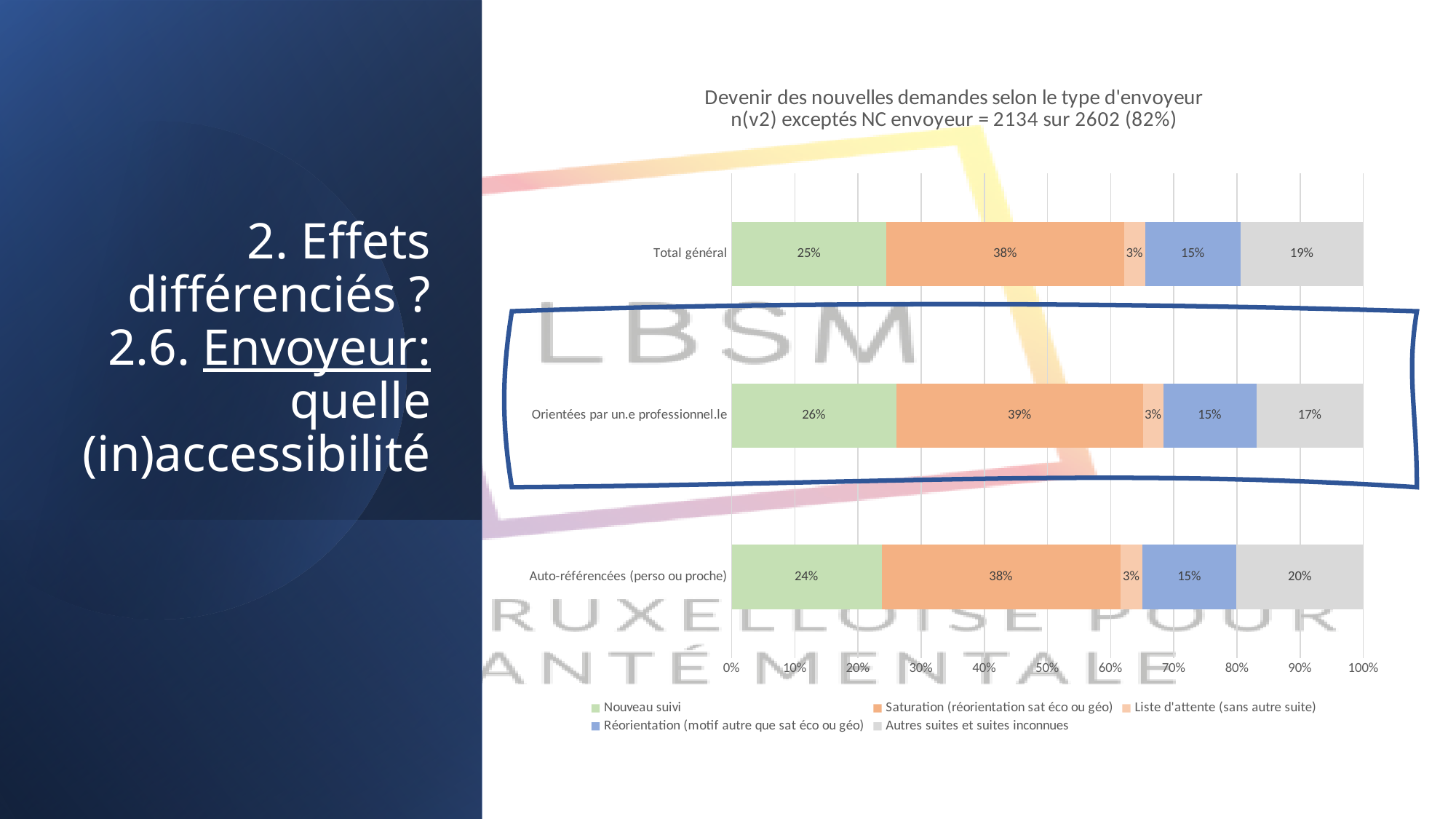
What is the value of "Réorientation (motif autre que sat éco ou géo)" for "Auto-référencées (perso ou proche)"? 15% Which category has the highest value for "Nouveau suivi"? Orientées par un.e professionnel.le What kind of chart is shown on the slide? Stacked bar chart What colour represents "Liste d'attente (sans autre suite)" in the chart? Light orange What is the value of "Autres suites et suites inconnues" for "Auto-référencées (perso ou proche)"? 20% What is the value of "Saturation (réorientation sat éco ou géo)" for "Total général"? 38% What is the difference between the "Autres suites et suites inconnues" values for "Auto-référencées (perso ou proche)" and "Orientées par un.e professionnel.le"? 3% Which is larger: the "Saturation (réorientation sat éco ou géo)" value for "Orientées par un.e professionnel.le" or for "Auto-référencées (perso ou proche)"? Orientées par un.e professionnel.le How many categories are shown on the chart? 3 What is the value of "Nouveau suivi" for "Orientées par un.e professionnel.le"? 26% How many series does the legend list? 5 Which category has the lowest value for "Autres suites et suites inconnues"? Orientées par un.e professionnel.le